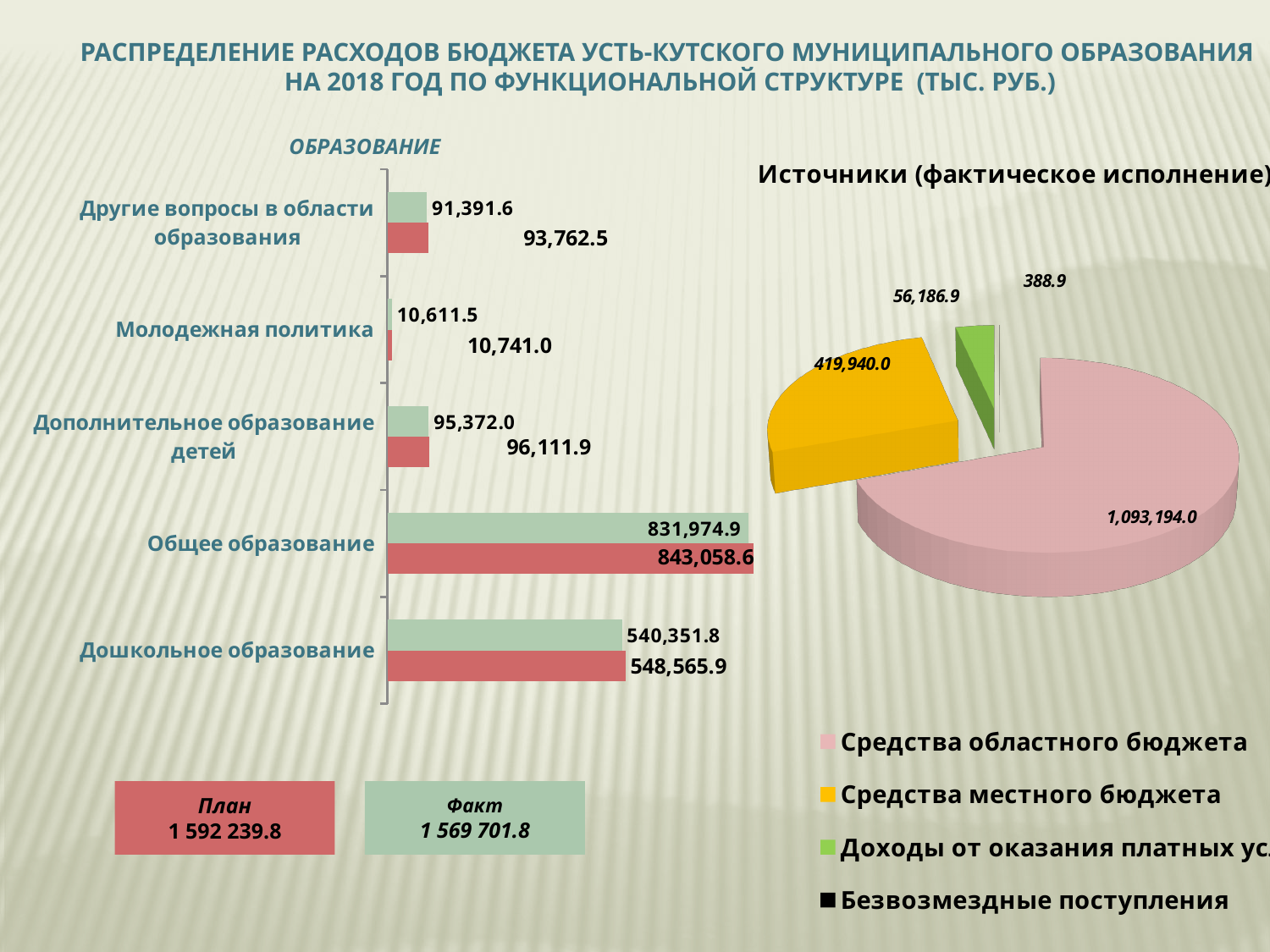
In the bar chart ОБРАЗОВАНИЕ, what is the difference between the План and Факт values for Общее образование? 11,083.7 In the bar chart ОБРАЗОВАНИЕ, how many categories are shown? 5 In the bar chart ОБРАЗОВАНИЕ, what is the План value for Общее образование? 843,058.6 In the pie chart Источники (фактическое исполнение), which source has the largest slice? Средства областного бюджета In the bar chart ОБРАЗОВАНИЕ, which category has the highest values? Общее образование In the bar chart ОБРАЗОВАНИЕ, which category has the lowest values? Молодежная политика In the bar chart ОБРАЗОВАНИЕ, what is the Факт value for Дошкольное образование? 540,351.8 How many entries does the legend of the pie chart Источники (фактическое исполнение) list? 4 In the pie chart Источники (фактическое исполнение), which source has the smallest value? Безвозмездные поступления In the bar chart ОБРАЗОВАНИЕ, what is the Факт value for Молодежная политика? 10,611.5 What kind of chart is the ОБРАЗОВАНИЕ chart on the left? Bar chart In the pie chart Источники (фактическое исполнение), what is the value for Средства местного бюджета? 419,940.0